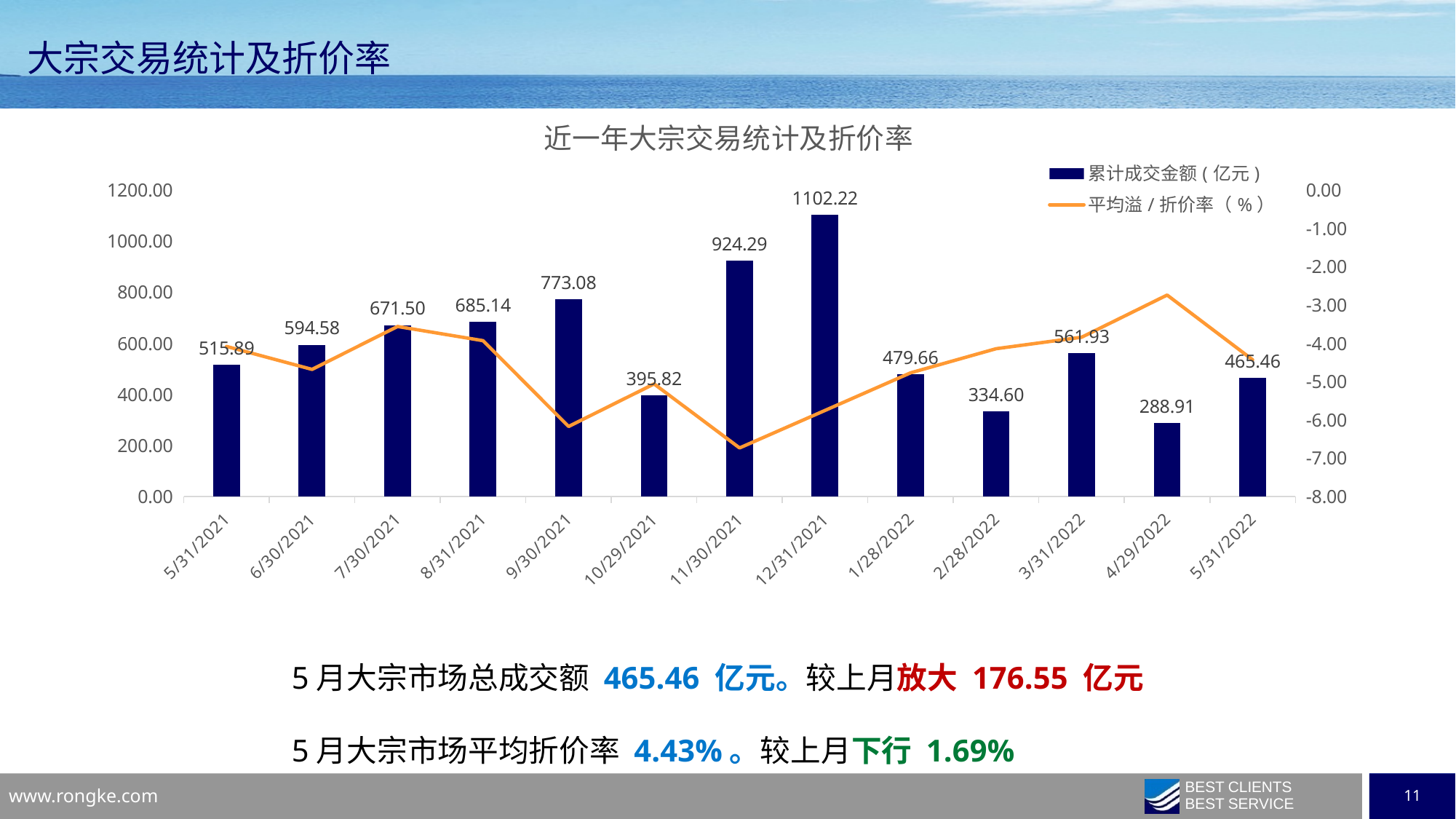
How many series does the chart legend list? 2 Which date has the lowest 累计成交金额 bar? 4/29/2022 What kind of chart is shown on the slide? Combined bar and line chart What is the difference in 累计成交金额 between 5/31/2022 and 4/29/2022? 176.55 Do the 累计成交金额 bars rise or fall from 5/31/2021 to 9/30/2021? rise Is the 平均溢/折价率 value for 11/30/2021 greater or less than -6.00? less What is the 累计成交金额 (亿元) value for 12/31/2021? 1102.22 What is the 累计成交金额 (亿元) value for 10/29/2021? 395.82 Which has a larger 累计成交金额, 11/30/2021 or 9/30/2021? 11/30/2021 Which date has the highest 累计成交金额 bar? 12/31/2021 What is the 累计成交金额 (亿元) value for 5/31/2022? 465.46 How many dates are shown on the x axis of the chart? 13